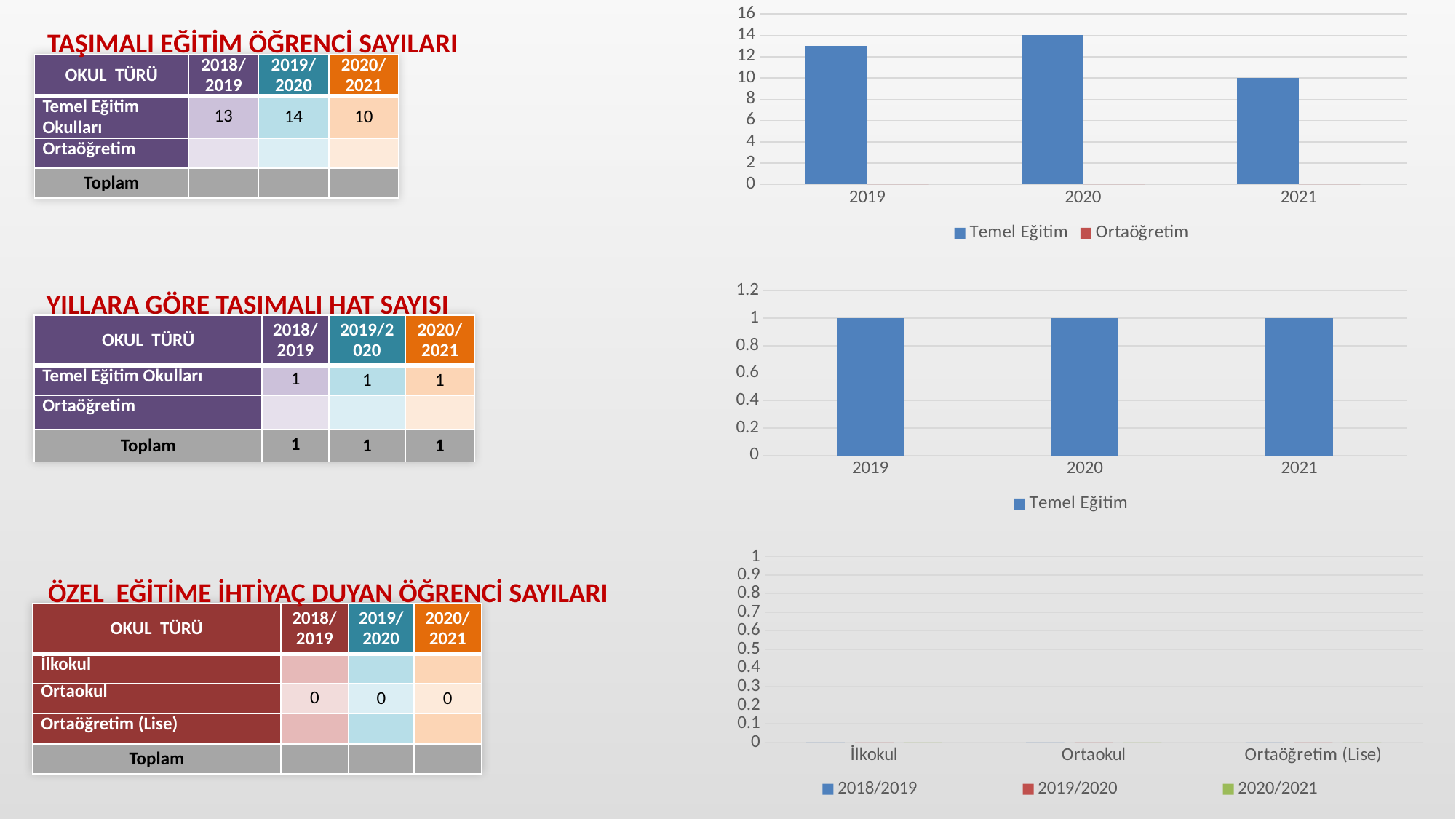
In the top chart, is the Temel Eğitim value for 2019 greater or less than 12? greater In the top chart, what is the difference between the Temel Eğitim values for 2020 and 2021? 4 What kind of chart is the top chart? bar chart In the bottom chart, how many series does the legend list? 3 In the top chart, which year has the highest Temel Eğitim bar? 2020 In the middle chart, what is the value of Temel Eğitim for 2019? 1 In the top chart, how many series does the legend list? 2 In the top chart, what is the value of Temel Eğitim for 2021? 10 In the middle chart, do the Temel Eğitim values rise, fall or stay flat from 2019 to 2021? stay flat In the top chart, what is the value of Temel Eğitim for 2020? 14 In the top chart, which year has the lowest Temel Eğitim bar? 2021 In the middle chart, how many years are shown on the x axis? 3